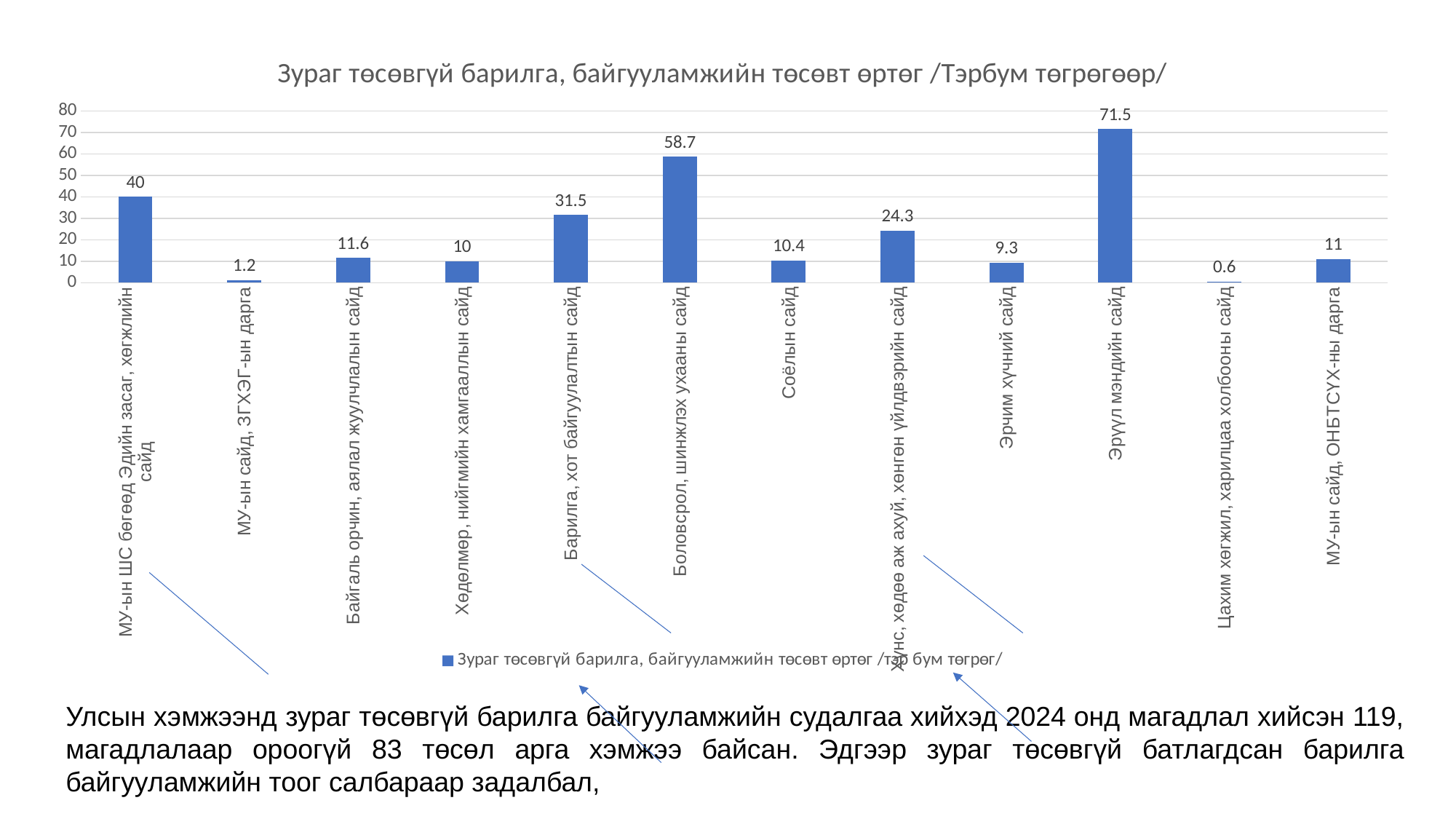
Which category has the highest value? Эрүүл мэндийн сайд What is the value for Эрүүл мэндийн сайд? 71.5 How many categories are shown on the x axis? 12 What is the value for Цахим хөгжил, харилцаа холбооны сайд? 0.6 What is the value for Боловсрол, шинжлэх ухааны сайд? 58.7 What is the value for Барилга, хот байгуулалтын сайд? 31.5 What is the difference between the values for Эрүүл мэндийн сайд and Боловсрол, шинжлэх ухааны сайд? 12.8 How many series does the legend list? 1 Which is larger: the value for Байгаль орчин, аялал жуулчлалын сайд or the value for Соёлын сайд? Байгаль орчин, аялал жуулчлалын сайд Which category has the lowest value? Цахим хөгжил, харилцаа холбооны сайд What type of chart is shown on the slide? bar chart What is the title of the chart? Зураг төсөвгүй барилга, байгууламжийн төсөвт өртөг /Тэрбум төгрөгөөр/